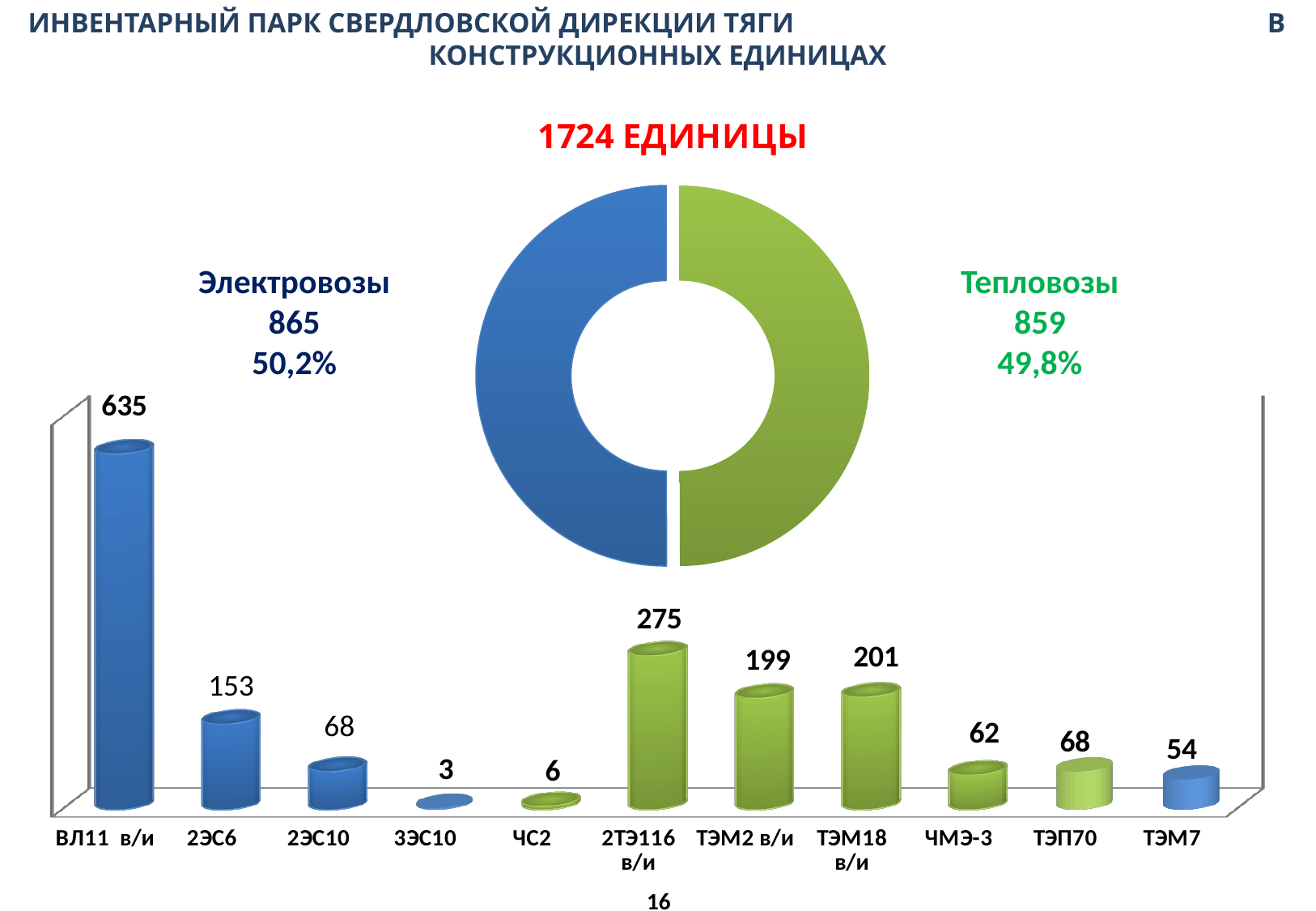
How many categories are shown in the bar chart? 11 In the donut chart, what is the value for Тепловозы? 859 What total number of units is shown above the donut chart? 1724 ЕДИНИЦЫ In the bar chart, what is the value for 2ТЭ116 в/и? 275 In the donut chart, what share of the total do Электровозы make up? 50,2% In the bar chart, which category has the lowest value? 3ЭС10 In the bar chart, which is larger, the value for 2ТЭ116 в/и or the value for ТЭМ18 в/и? 2ТЭ116 в/и In the bar chart, which category has the highest value? ВЛ11 в/и In the bar chart, what is the value for ВЛ11 в/и? 635 In the bar chart, what is the value for ТЭМ7? 54 What kind of chart is the chart at the bottom of the slide? bar chart In the bar chart, what is the difference between the values for ВЛ11 в/и and 2ЭС6? 482